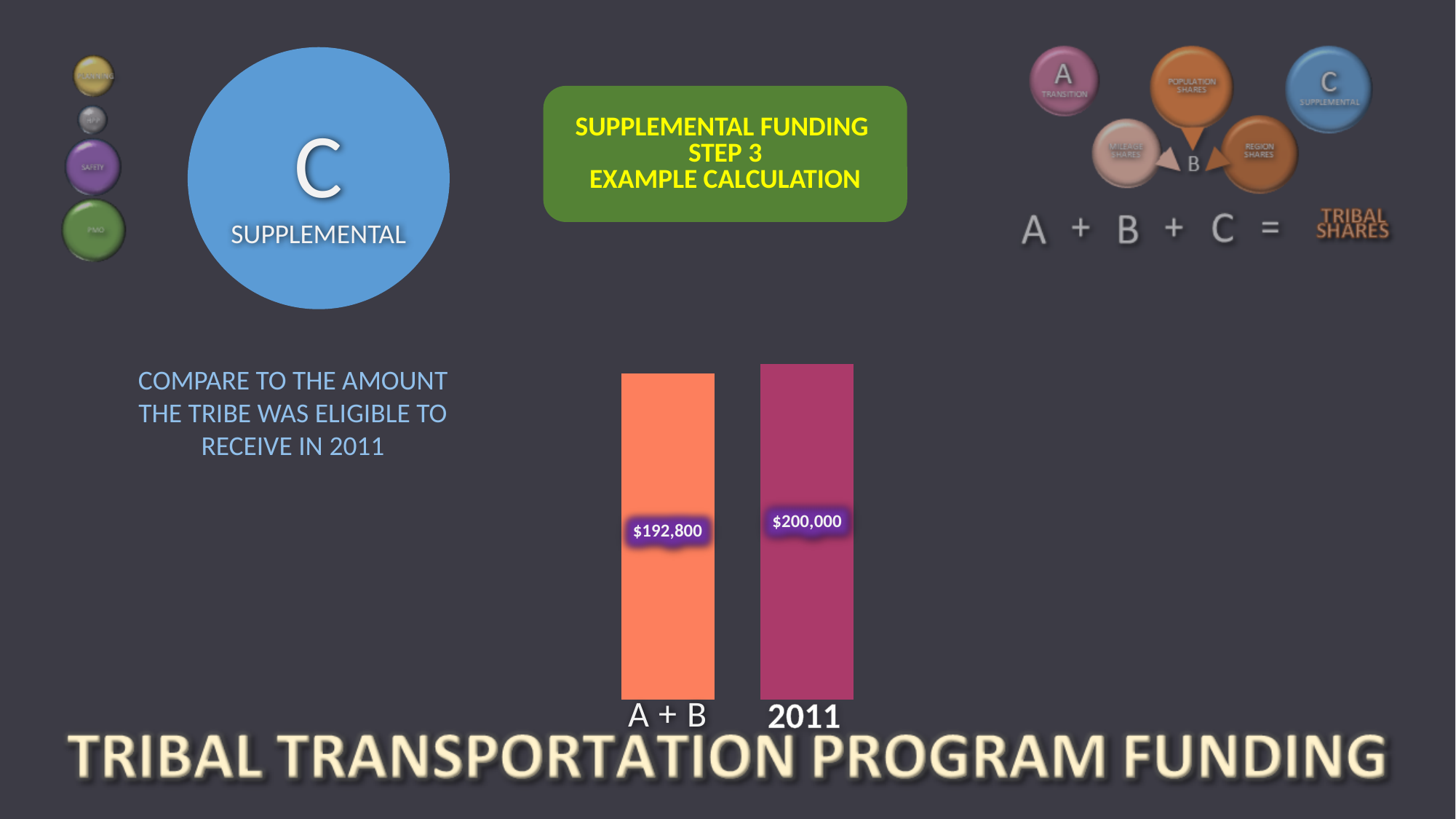
Which bar has the lowest value? A + B Which bar is taller, A + B or 2011? 2011 Is the value for A + B larger or smaller than the value for 2011? smaller How many bars are shown in the chart? 2 What is the difference between the 2011 value and the A + B value? $7,200 What kind of chart is shown on the slide? bar chart What is the value of the A + B bar? $192,800 What colour is the 2011 bar? magenta What colour is the A + B bar? orange What is the value of the 2011 bar? $200,000